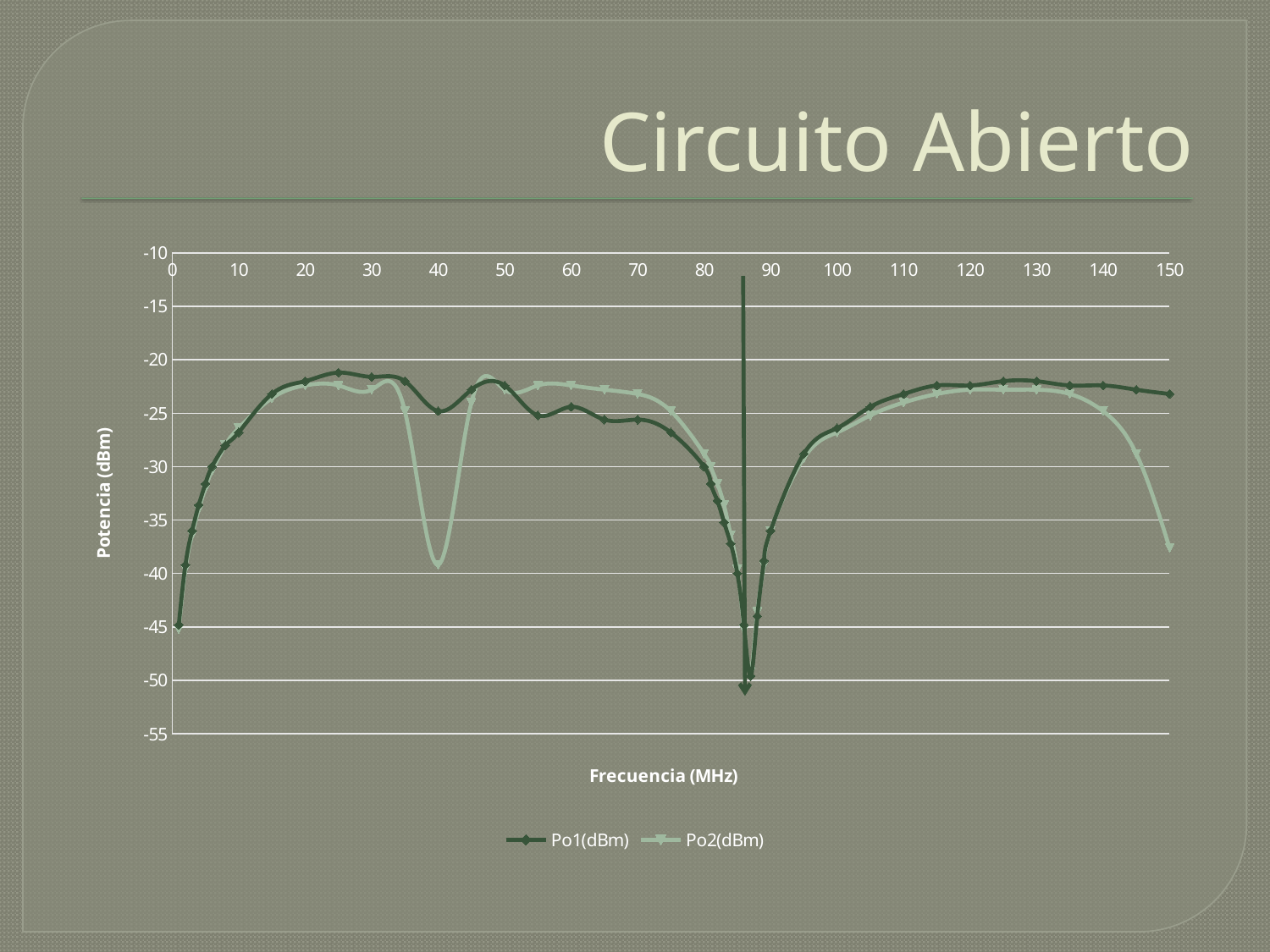
Does the Po2(dBm) series rise or fall between 130 MHz and 150 MHz? fall What are the names of the two series in the legend? Po1(dBm) and Po2(dBm) What kind of chart is shown on the slide? line chart What is the title of the x axis? Frecuencia (MHz) Is the value of Po2(dBm) at 40 MHz greater or less than -35? less Which series has the larger value at 150 MHz, Po1(dBm) or Po2(dBm)? Po1(dBm) Is the value of Po1(dBm) at 0 MHz greater or less than -40? less Is the value of Po2(dBm) at 150 MHz greater or less than -35? less Which series has the larger value at 40 MHz, Po1(dBm) or Po2(dBm)? Po1(dBm) How many series does the legend list? 2 Does the Po1(dBm) series rise or fall between 0 MHz and 20 MHz? rise